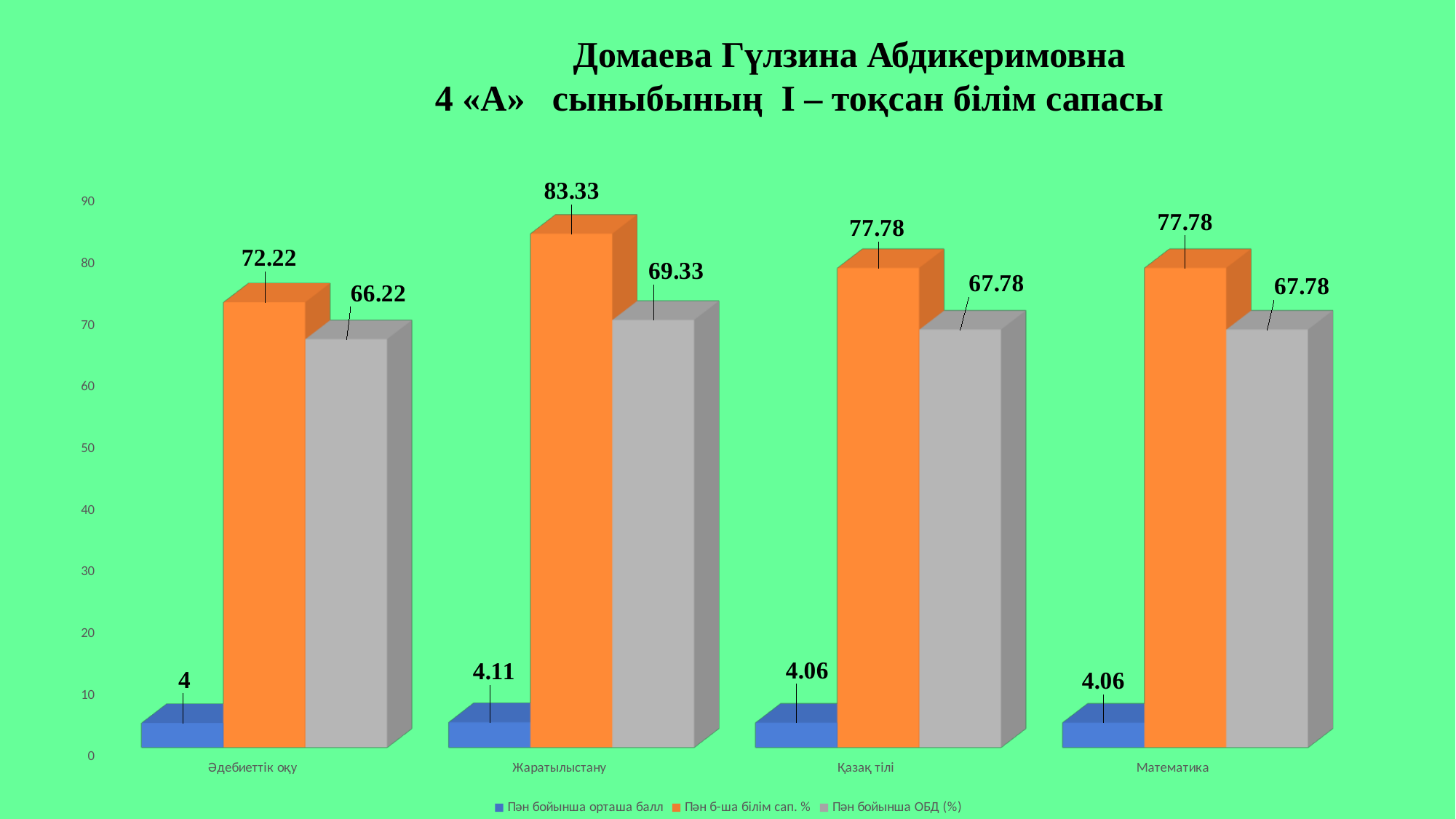
What is the value of Пән бойынша ОБД (%) for Математика? 67.78 How many series does the legend list? 3 How many categories are shown on the x axis? 4 What is the difference between the Пән б-ша білім сап. % values for Жаратылыстану and Әдебиеттік оқу? 11.11 Which series is shown in orange in the legend? Пән б-ша білім сап. % What kind of chart is shown on the slide? Bar chart What is the value of Пән бойынша орташа балл for Жаратылыстану? 4.11 Which category has the lowest value for Пән бойынша орташа балл? Әдебиеттік оқу Which category has the highest value for Пән б-ша білім сап. %? Жаратылыстану What is the value of Пән б-ша білім сап. % for Жаратылыстану? 83.33 Which is larger: the Пән бойынша ОБД (%) value for Жаратылыстану or for Қазақ тілі? Жаратылыстану What is the value of Пән бойынша ОБД (%) for Әдебиеттік оқу? 66.22